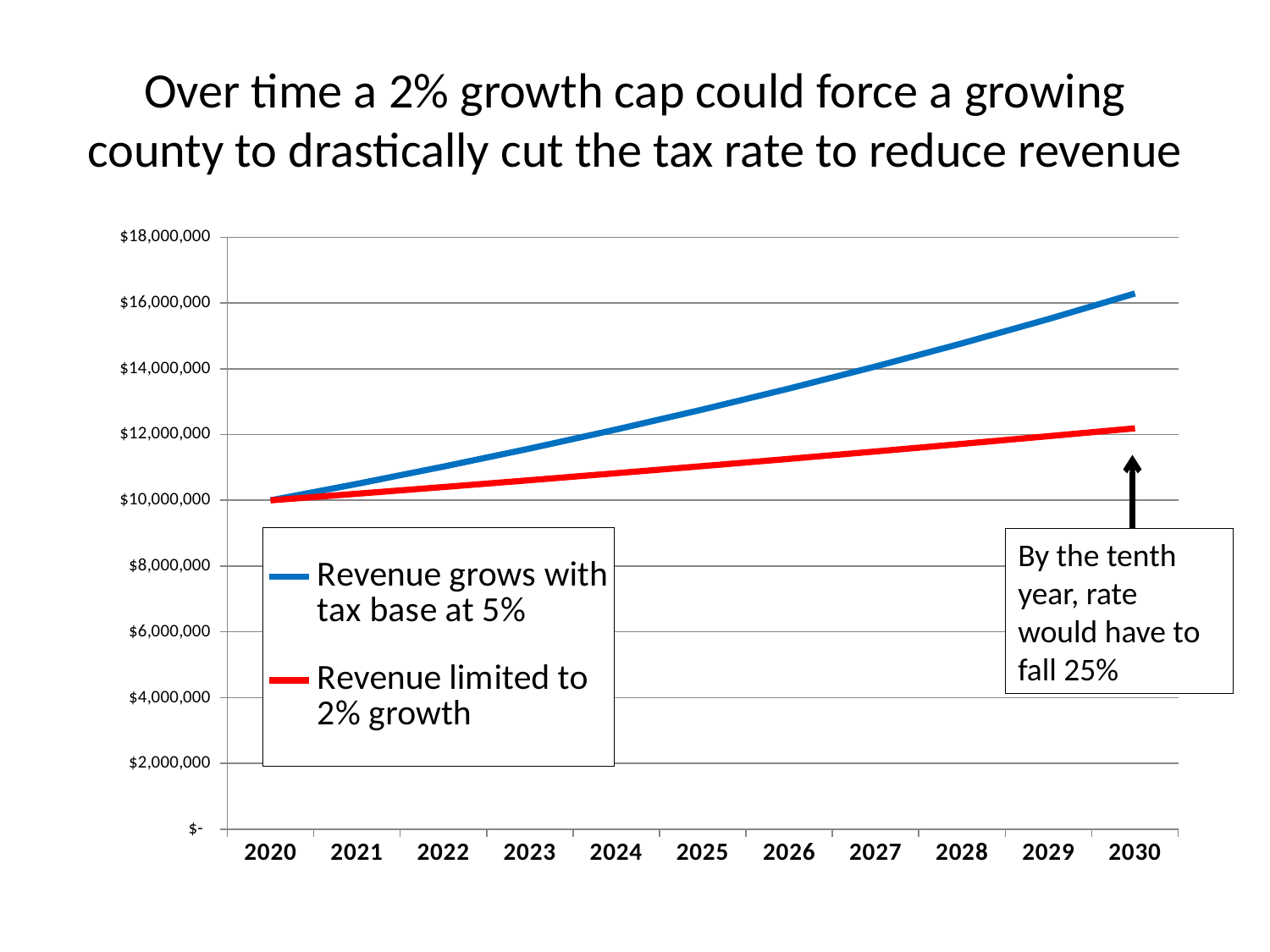
What kind of chart is shown on the slide? line chart Is the value for 'Revenue limited to 2% growth' in 2025 greater or less than $12,000,000? less In 2030, which series has the larger value: 'Revenue grows with tax base at 5%' or 'Revenue limited to 2% growth'? Revenue grows with tax base at 5% Is the value for 'Revenue limited to 2% growth' in 2030 greater or less than $14,000,000? less What colour is the line for 'Revenue limited to 2% growth'? red Is the value for 'Revenue grows with tax base at 5%' in 2025 greater or less than $12,000,000? greater What is the value of the 'Revenue grows with tax base at 5%' series in 2020? $10,000,000 How many years are shown on the x axis? 11 Does the 'Revenue limited to 2% growth' series rise or fall from 2020 to 2030? rise What is the value of the 'Revenue limited to 2% growth' series in 2020? $10,000,000 How many series does the legend list? 2